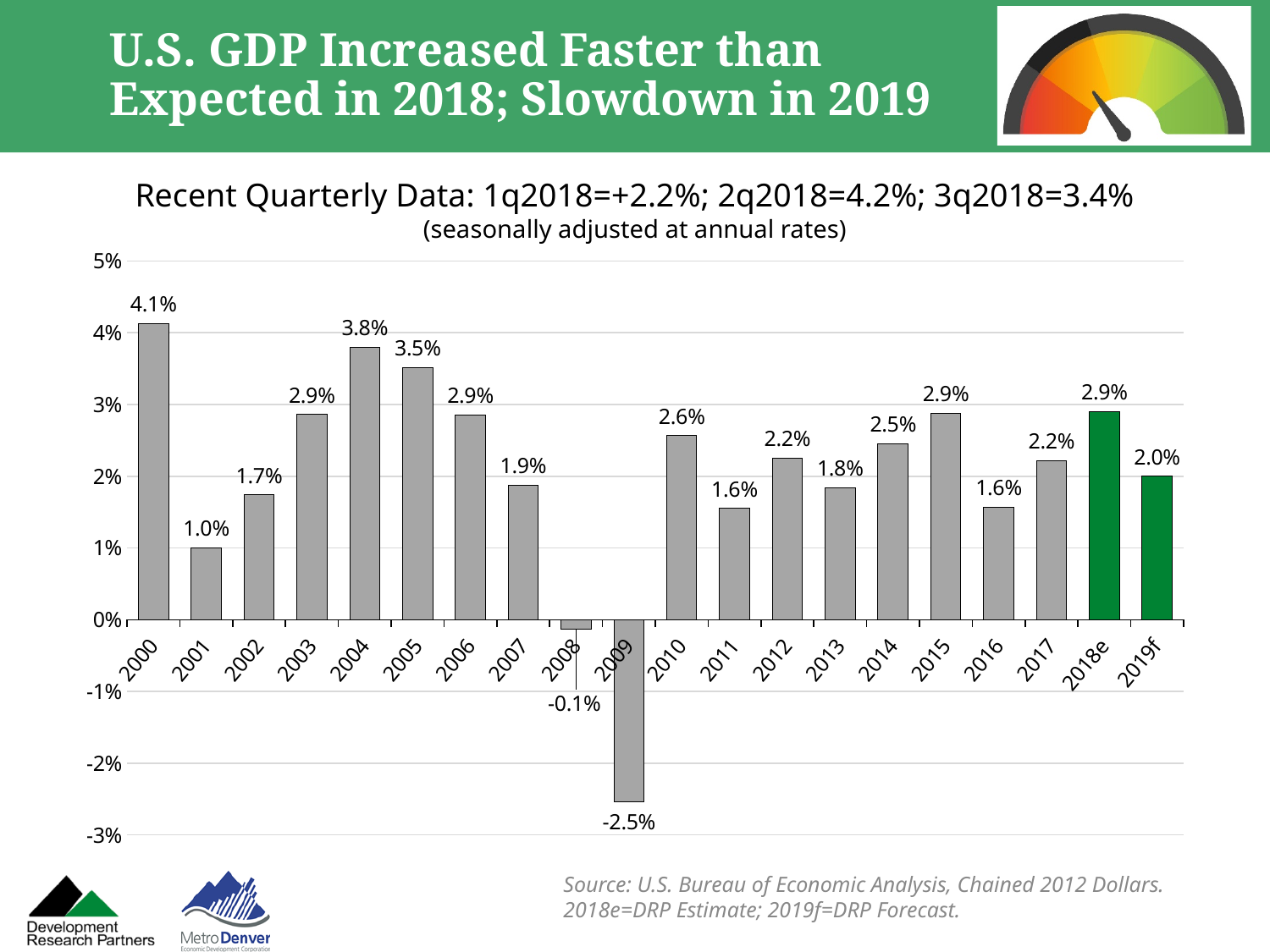
What is the difference between the values for 2018e and 2019f? 0.9 percentage points What kind of chart is this? Bar chart What is the value for 2000? 4.1% Which year has the highest value? 2000 Which year has the lowest value? 2009 What colour are the bars for 2018e and 2019f? Green What is the forecast value for 2019f? 2.0% How many years are shown on the x axis? 20 Do the values rise or fall from 2000 to 2002? Fall Which is larger, the value for 2004 or the value for 2017? 2004 What is the value for 2008? -0.1% What is the value for 2009? -2.5%